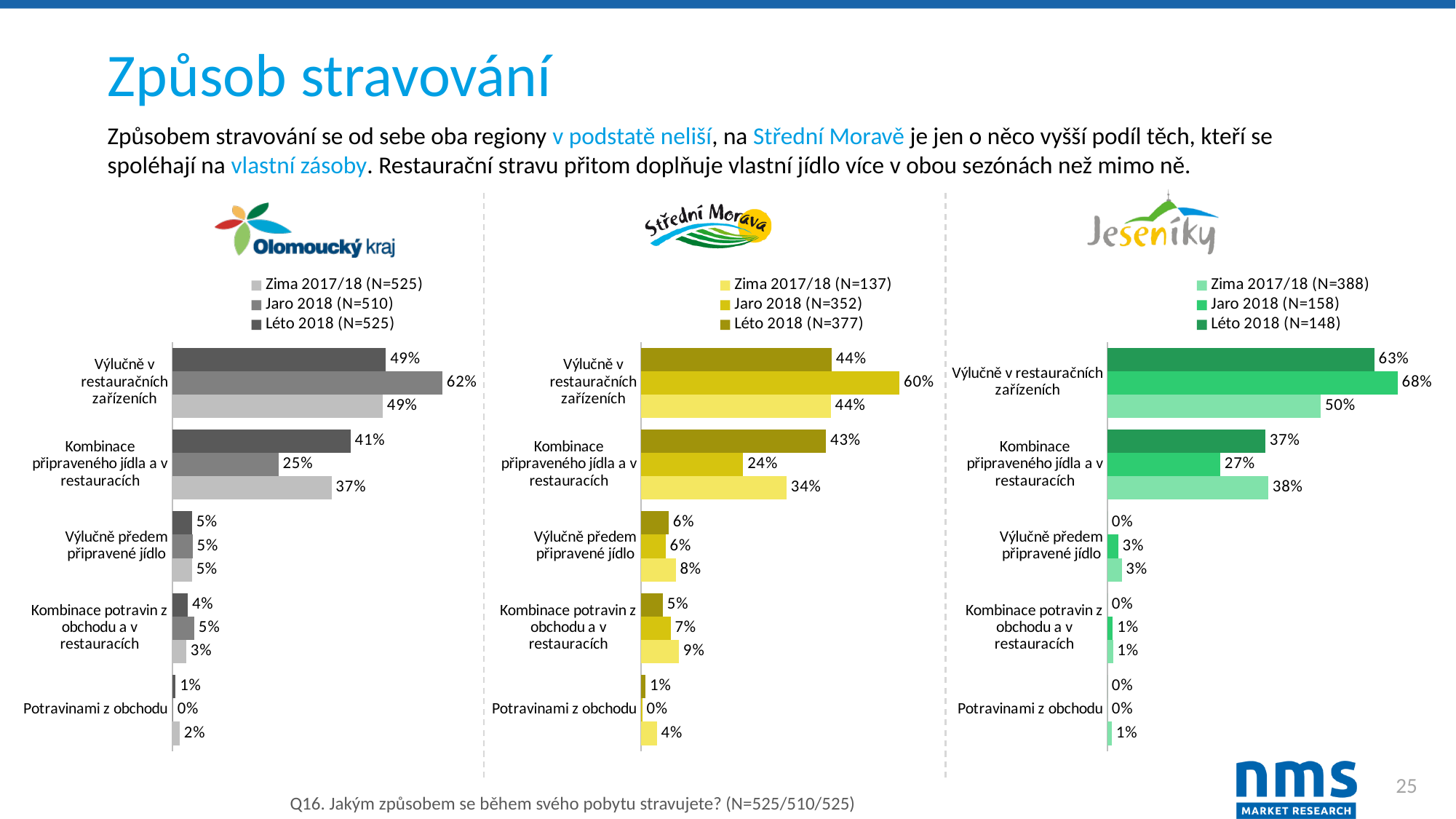
How many categories are shown in the Jeseníky chart? 5 In the Jeseníky chart, which series has the highest value in the category 'Výlučně v restauračních zařízeních'? Jaro 2018 (N=158) In the Střední Morava chart, which category has the lowest value for Jaro 2018? Potravinami z obchodu What sample size (N) is given for Jaro 2018 in the legend of the Střední Morava chart? N=352 In the Olomoucký kraj chart, what is the value for Jaro 2018 in the category 'Výlučně v restauračních zařízeních'? 62% In the Střední Morava chart, which is larger for 'Výlučně předem připravené jídlo': the Zima 2017/18 value or the Léto 2018 value? Zima 2017/18 What type of chart is used for the Střední Morava data? Bar chart How many series does the legend of the Olomoucký kraj chart list? 3 In the Jeseníky chart, what is the value for Zima 2017/18 in the category 'Výlučně v restauračních zařízeních'? 50% In the Olomoucký kraj chart, what is the difference between the Léto 2018 and Jaro 2018 values for 'Kombinace připraveného jídla a v restauracích'? 16% In the Jeseníky chart, what is the value for Léto 2018 in the category 'Potravinami z obchodu'? 0% In the Střední Morava chart, what is the value for Léto 2018 in the category 'Kombinace připraveného jídla a v restauracích'? 43%